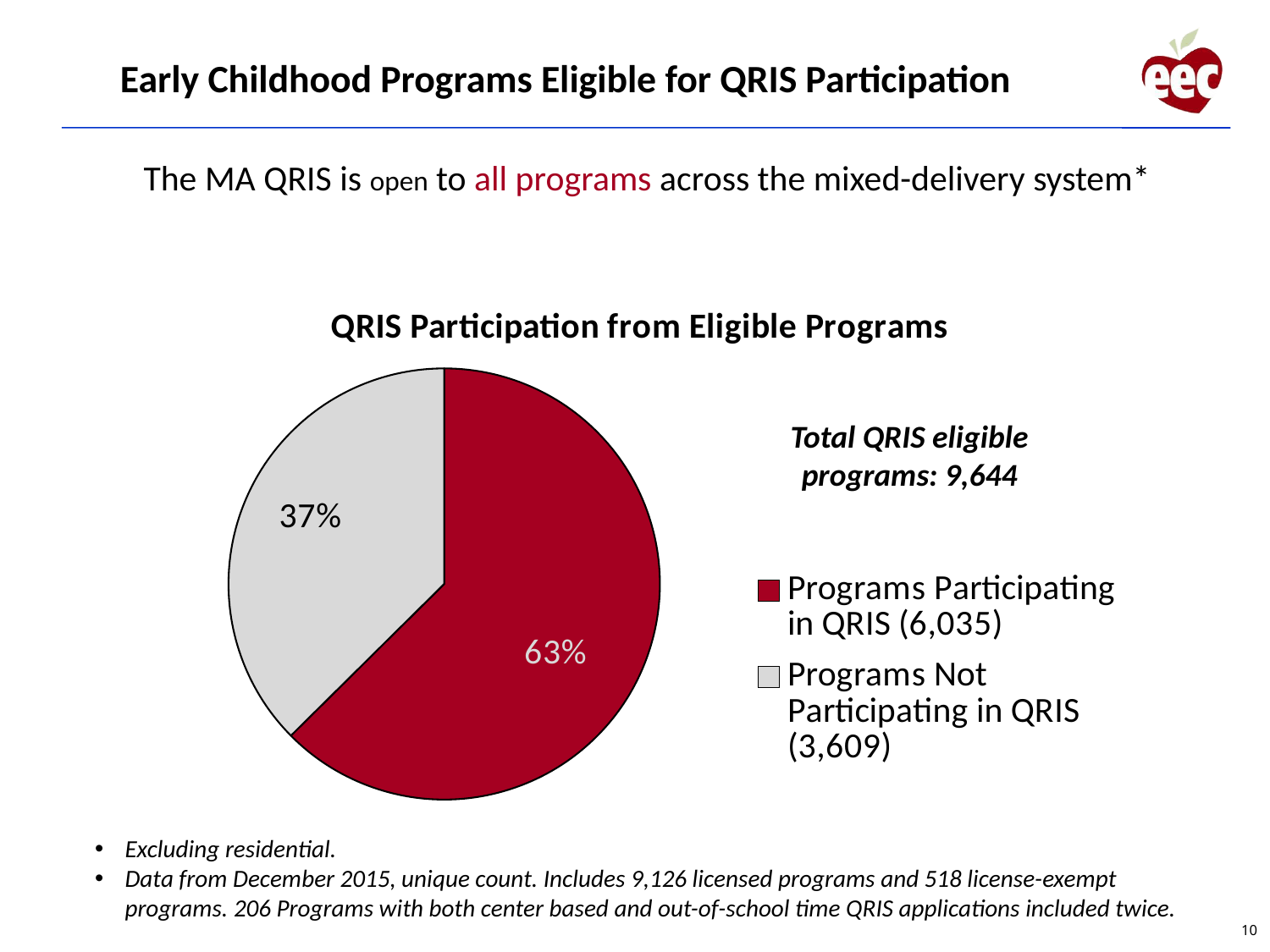
How many slices does the pie chart have? 2 How many programs are participating in QRIS, according to the legend? 6,035 How many programs are not participating in QRIS, according to the legend? 3,609 What colour is the slice for Programs Participating in QRIS? red What share of the pie is labelled for Programs Not Participating in QRIS? 37% What is the difference in percentage points between the participating and not participating slices? 26 percentage points What is the title of the chart? QRIS Participation from Eligible Programs What is the total number of QRIS eligible programs stated on the slide? 9,644 Which slice of the pie is the largest? Programs Participating in QRIS Which slice of the pie is the smallest? Programs Not Participating in QRIS What share of the pie is labelled for Programs Participating in QRIS? 63% What kind of chart is shown on the slide? pie chart